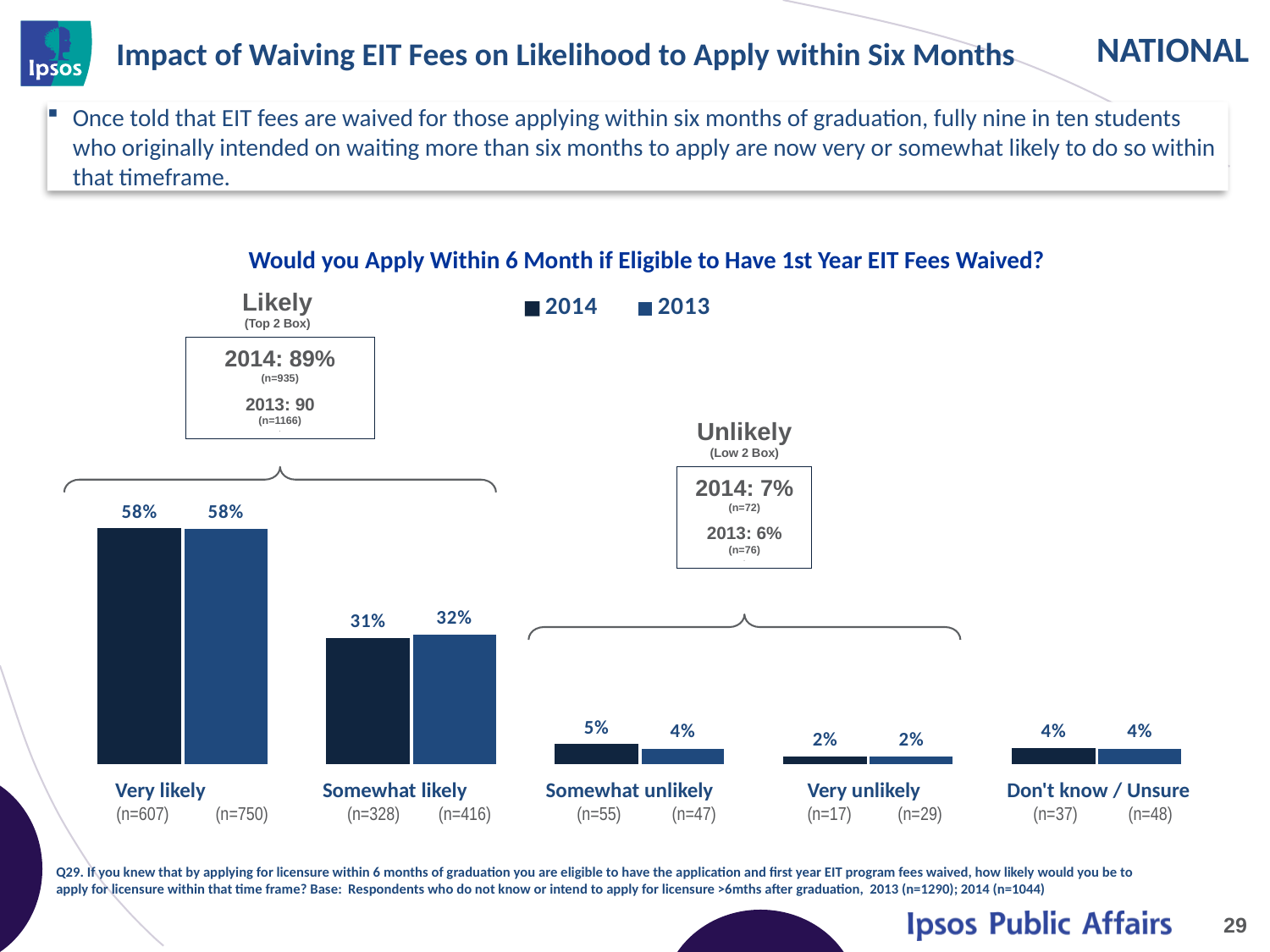
What is the difference between the 2014 values for Very likely and Somewhat likely? 27% What kind of chart is shown? Bar chart What is the 2013 value for Very likely? 58% What is the 2014 value for Somewhat unlikely? 5% Which category has the highest 2014 value? Very likely How many categories are shown on the x axis? 5 Which is larger for Somewhat unlikely, the 2014 value or the 2013 value? 2014 Which category has the lowest 2013 value? Very unlikely What is the 2014 value for Somewhat likely? 31% What is the 2013 value for Somewhat likely? 32% What is the title of the chart? Would you Apply Within 6 Month if Eligible to Have 1st Year EIT Fees Waived? How many series does the legend list? 2